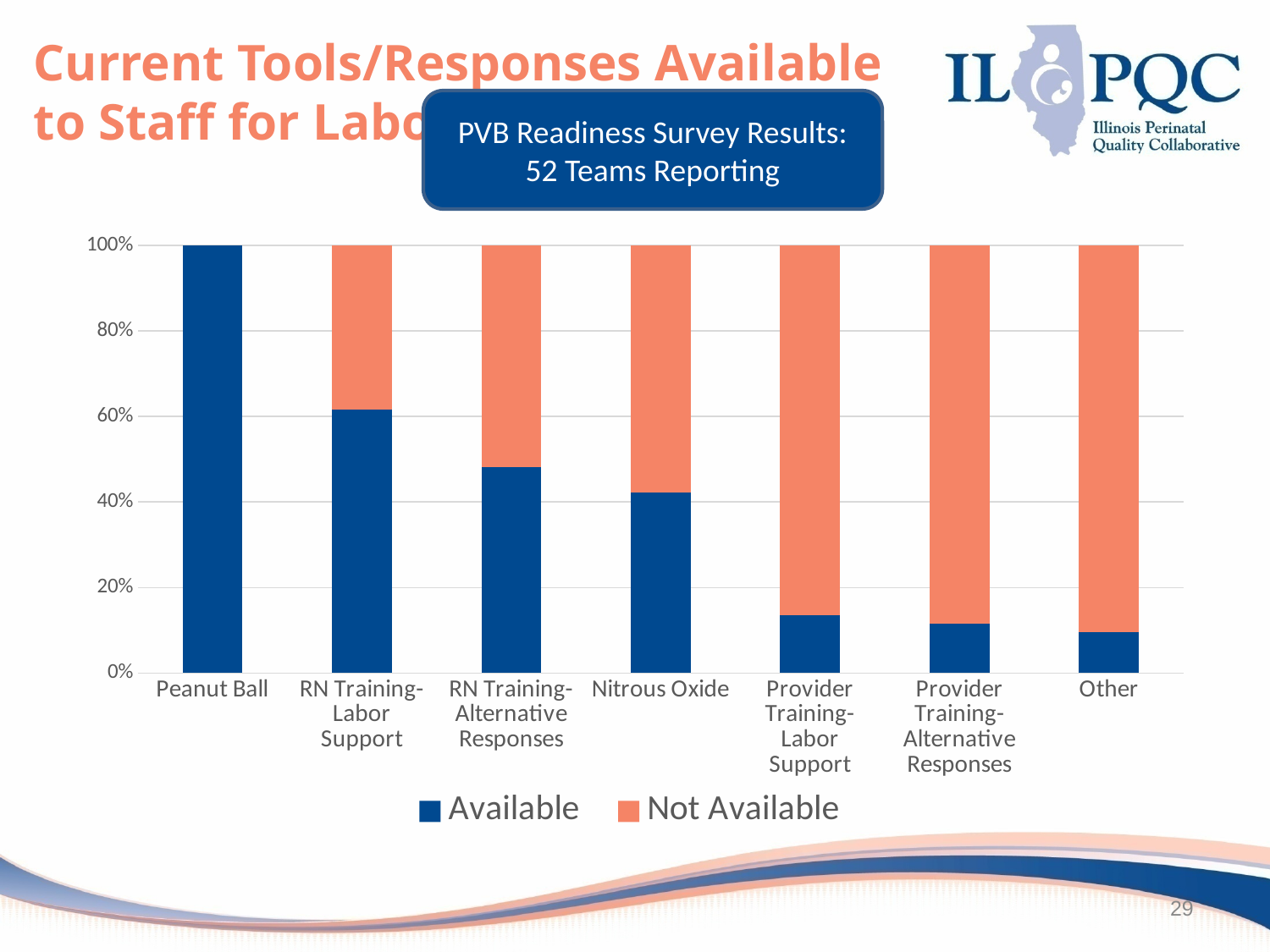
What is the Available value for Peanut Ball? 100% Is the Available value for Provider Training-Labor Support greater or less than 20%? less Which category has the highest Available share? Peanut Ball Which has a larger Available share, RN Training-Labor Support or Nitrous Oxide? RN Training-Labor Support How many series does the chart's legend list? 2 According to the text box above the chart, how many teams reported in the PVB Readiness Survey? 52 Teams Is the Available value for RN Training-Alternative Responses greater or less than 60%? less How many categories are shown along the x axis of the chart? 7 What kind of chart is shown on the slide? Stacked bar chart Is the Available value for RN Training-Labor Support greater or less than 40%? greater Does the Available share generally rise or fall moving from left to right across the categories? Fall Which colour represents the Not Available series in the chart? Orange